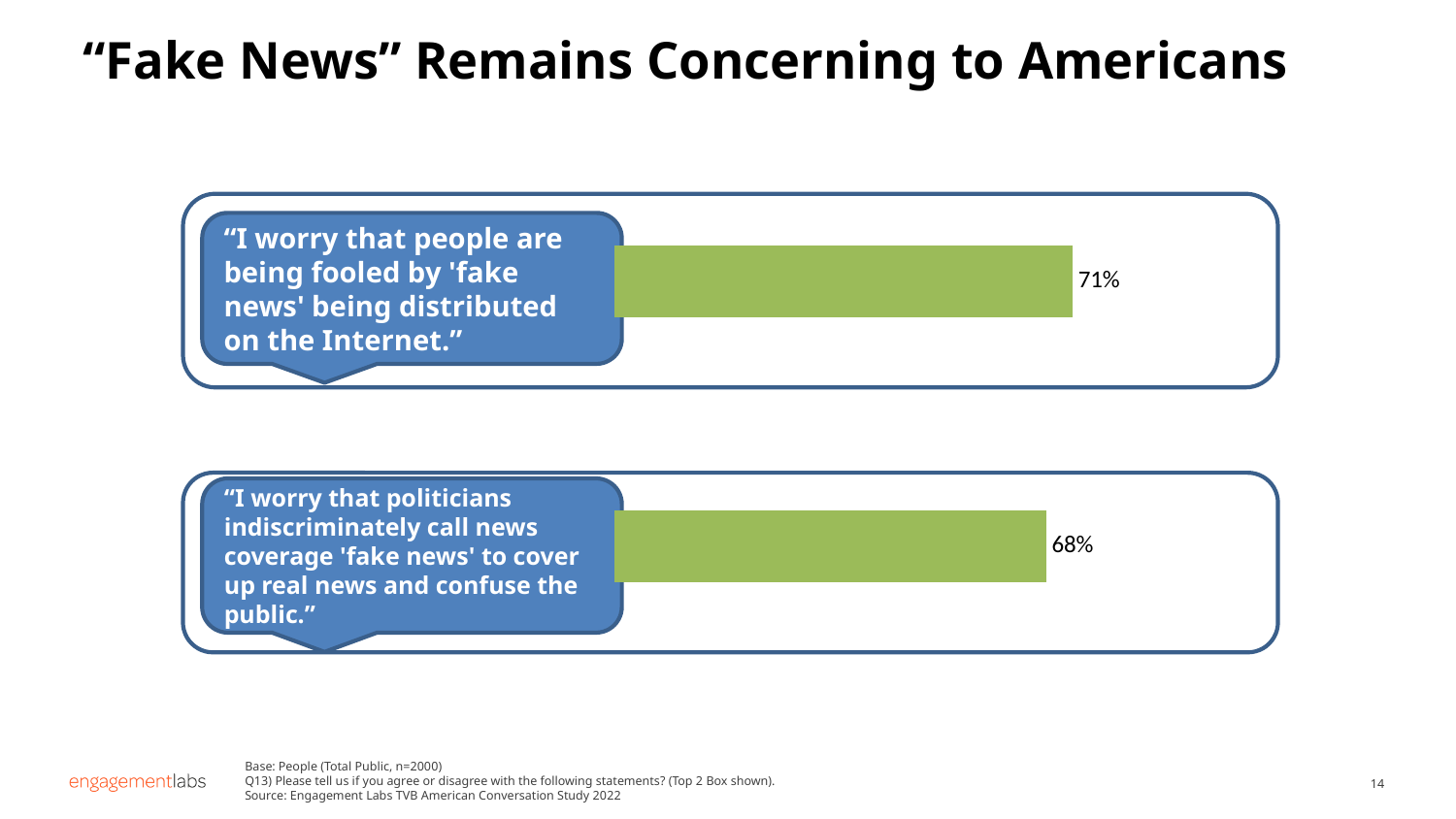
What is the title of the slide? "Fake News" Remains Concerning to Americans What percentage of people agree with the statement "I worry that people are being fooled by 'fake news' being distributed on the Internet"? 71% What colour are the bars on the slide? Green Is the value for the statement about politicians calling news coverage 'fake news' larger or smaller than the value for the statement about people being fooled by fake news on the Internet? smaller How many statements are shown with bars on the slide? 2 What percentage of people agree with the statement "I worry that politicians indiscriminately call news coverage 'fake news' to cover up real news and confuse the public"? 68% What kind of chart is used to show the agreement levels on the slide? Bar chart What is the base sample size (n) noted at the bottom of the slide? n=2000 Is the value for the statement about people being fooled by fake news on the Internet greater or less than 70%? greater Which statement has the higher level of agreement? "I worry that people are being fooled by 'fake news' being distributed on the Internet." Which statement has the lower level of agreement? "I worry that politicians indiscriminately call news coverage 'fake news' to cover up real news and confuse the public." What is the difference in percentage points between agreement with the statement about people being fooled by fake news on the Internet and the statement about politicians calling news coverage fake news? 3 percentage points